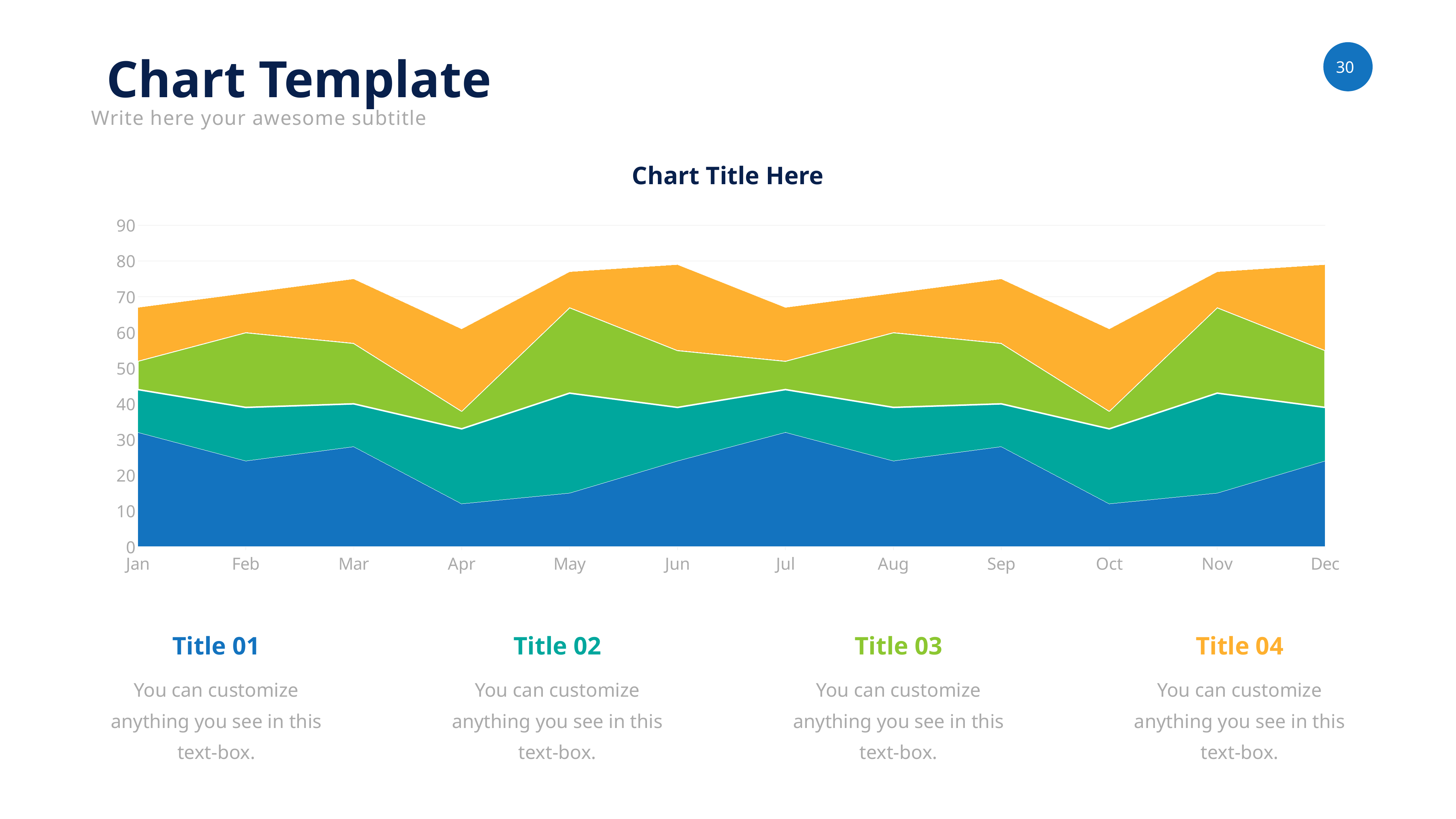
What is the title of the chart? Chart Title Here Is the value of the bottom (dark blue) series in Jul greater or less than 20? greater Which month has a higher total stacked value, Jun or Apr? Jun What kind of chart is shown on the slide? Stacked area chart Does the bottom (dark blue) series rise or fall from Apr to Jul? rise Is the top of the stacked area in Apr greater or less than 70? less How many coloured series are stacked in the chart? 4 Which month has a higher value for the bottom (dark blue) series, Jan or Apr? Jan Is the top of the stacked area in Jun greater or less than 70? greater How many months are shown along the x axis of the chart? 12